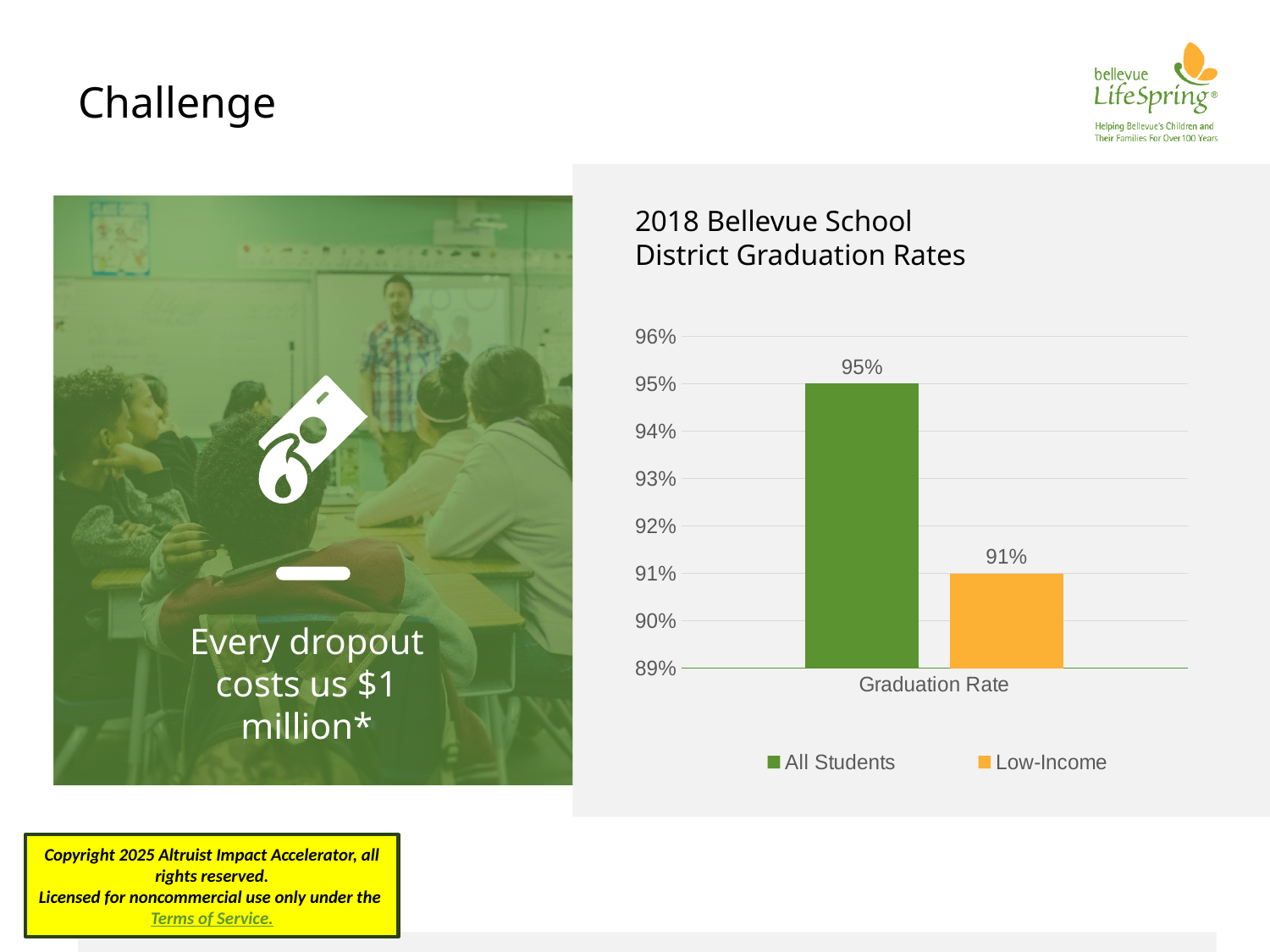
Is the All Students graduation rate greater or less than 94%? greater What kind of chart is shown on the slide? Bar chart Which series has the higher graduation rate, All Students or Low-Income? All Students What is the graduation rate for All Students? 95% What colour is the bar for Low-Income students? Orange How many series does the legend list? 2 Which series has the lowest graduation rate? Low-Income What is the graduation rate for Low-Income students? 91% Is the Low-Income graduation rate greater or less than 92%? less What is the category label shown on the x axis of the chart? Graduation Rate What is the difference in percentage points between the All Students and Low-Income graduation rates? 4 percentage points What is the title of the chart? 2018 Bellevue School District Graduation Rates